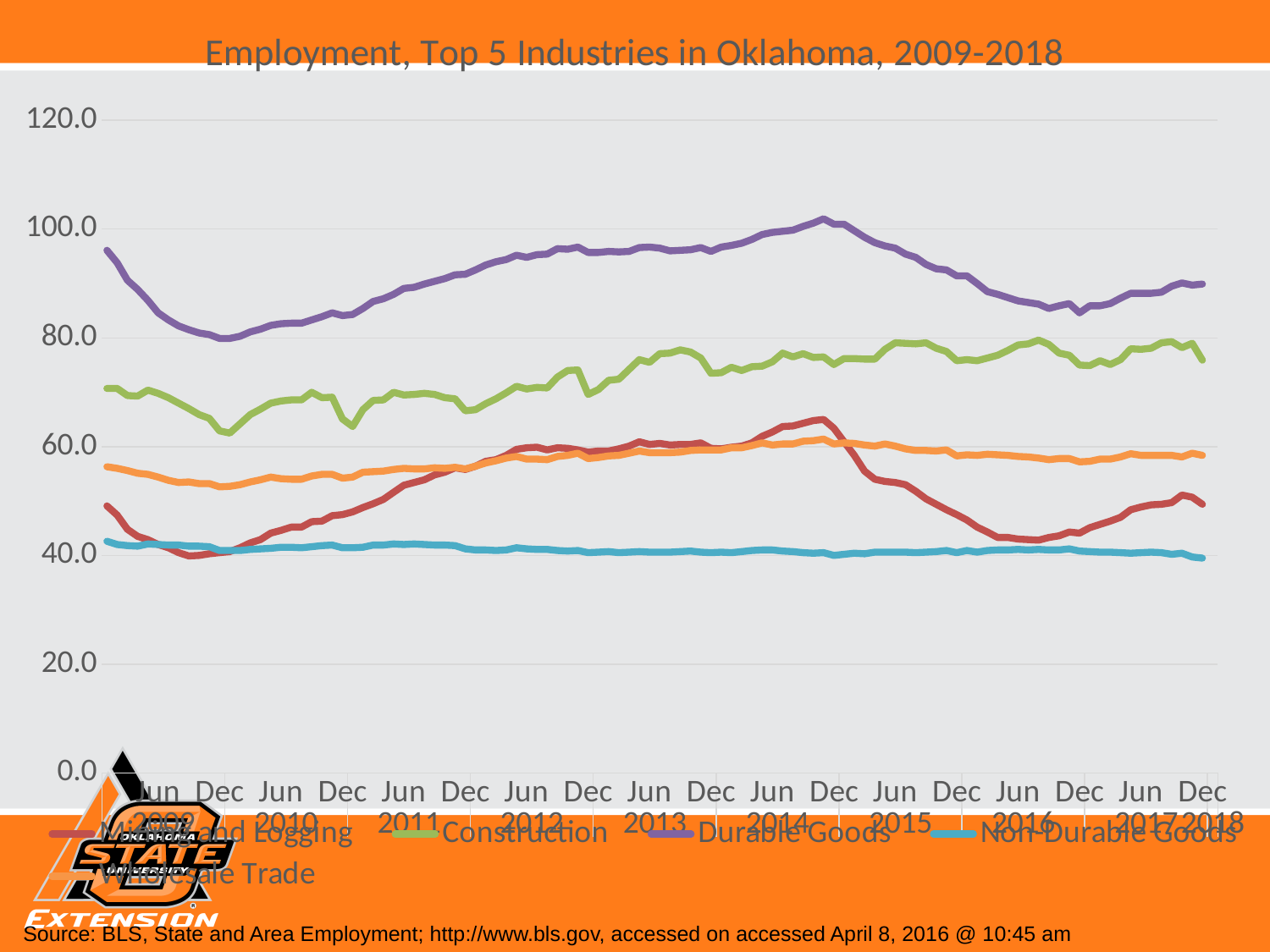
Does the Mining and Logging line rise or fall between Dec 2014 and Jun 2016? fall What is the title of the chart? Employment, Top 5 Industries in Oklahoma, 2009-2018 Is the value for Wholesale Trade in Jun 2009 greater or less than 40? greater Is the value for Durable Goods at the start of 2009 greater or less than 80? greater What kind of chart is shown on the slide? Line chart Does the Durable Goods line rise or fall between Dec 2009 and Dec 2014? rise Which industry has the highest employment line throughout the chart? Durable Goods Which is larger in Jun 2012, the value for Construction or the value for Wholesale Trade? Construction Is the value for Construction in Dec 2009 greater or less than 80? less How many series does the legend list? 5